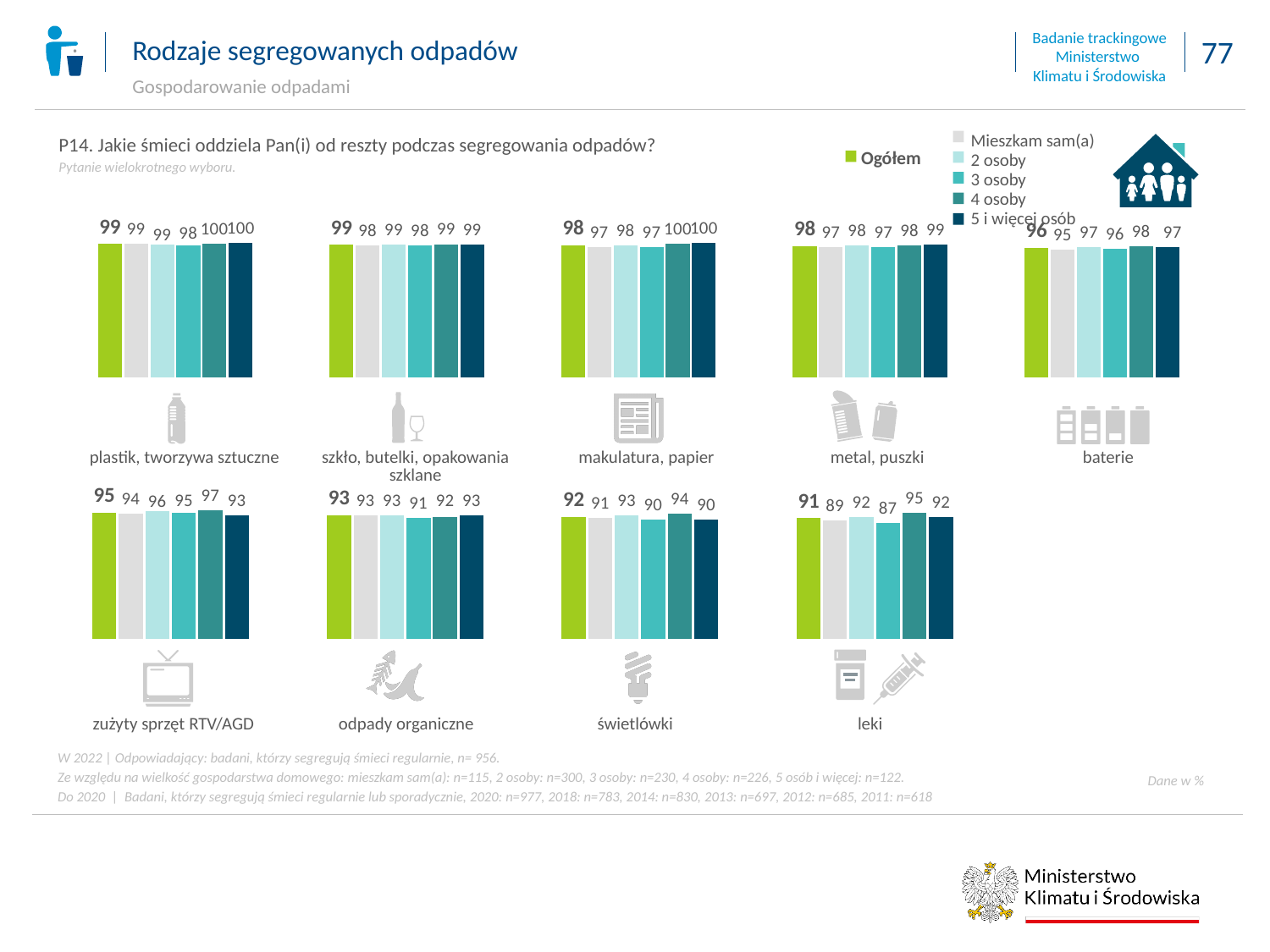
Which waste type has the lowest 'Ogółem' value across all nine charts? leki How many series does the legend at the top right list? 6 In the 'leki' chart, what is the value for the 'Ogółem' bar? 91 In the 'leki' chart, what is the difference between the '4 osoby' value and the '3 osoby' value? 8 In the 'zużyty sprzęt RTV/AGD' chart, which group has the highest value? 4 osoby What type of chart is used for 'makulatura, papier'? bar chart In the 'świetlówki' chart, what is the value for 'Mieszkam sam(a)'? 91 In the 'baterie' chart, what is the value for '4 osoby'? 98 How many bars does each small chart on the slide contain? 6 In the 'odpady organiczne' chart, which is larger: the value for '3 osoby' or the value for '5 i więcej osób'? 5 i więcej osób In the 'świetlówki' chart, what is the difference between the '4 osoby' value and the '5 i więcej osób' value? 4 In the 'leki' chart, which household-size group has the lowest value? 3 osoby